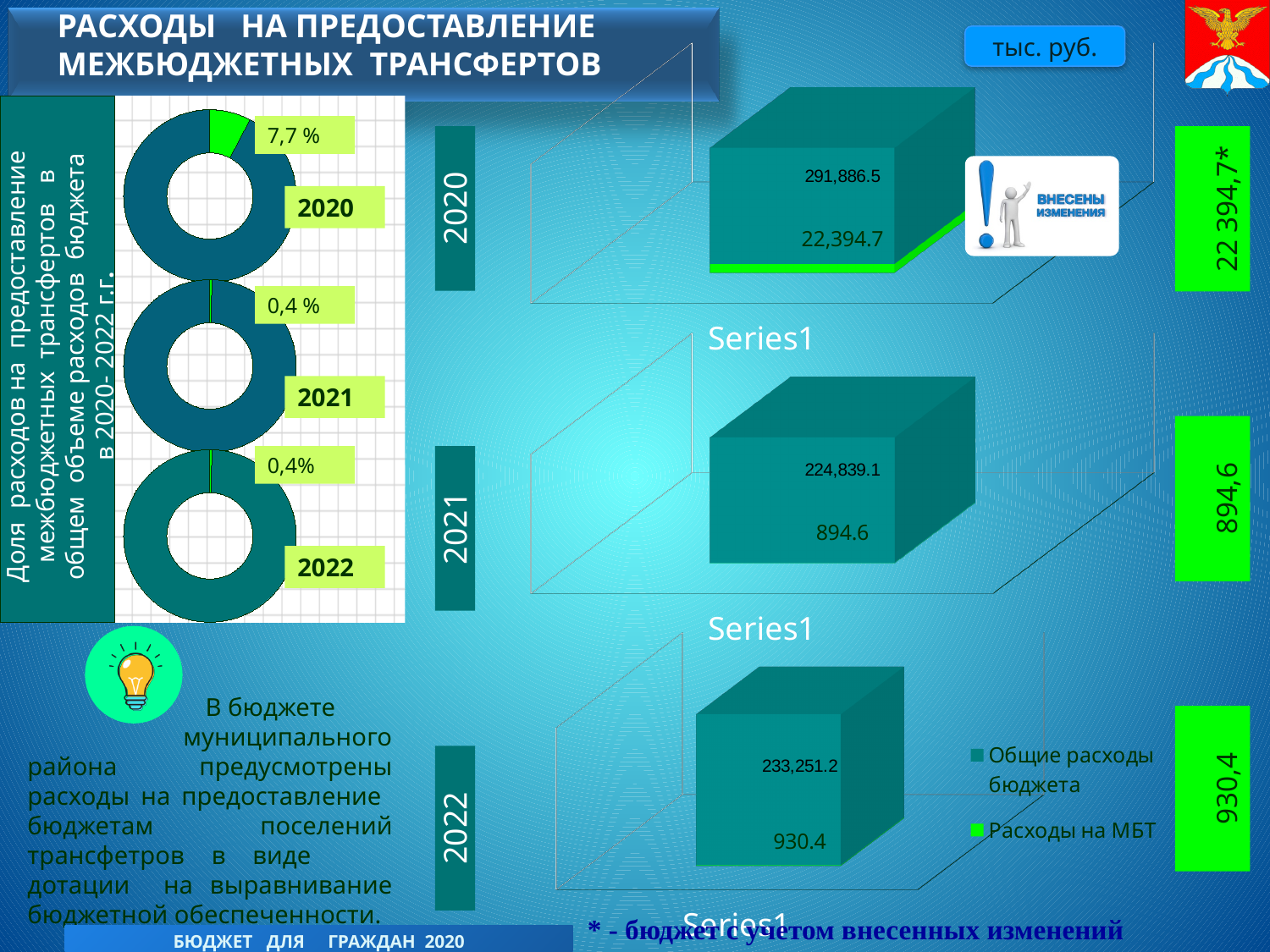
Across the three bar charts on the right, which year has the highest value for Расходы на МБТ? 2020 In the 2020 donut chart on the left, what share is shown for the highlighted slice? 7,7 % In the 2021 donut chart on the left, what share is shown for the highlighted slice? 0,4 % How many series does the legend of the bar charts on the right list? 2 In the 2021 bar chart on the right, what is the value labelled for Общие расходы бюджета? 224,839.1 In the 2020 bar chart on the right, what is the value labelled for Расходы на МБТ? 22,394.7 In the 2022 bar chart on the right, what is the value labelled for Расходы на МБТ? 930.4 What type of chart is used for the three charts on the left showing 7,7 %, 0,4 % and 0,4%? Donut (pie) chart In the 2020 bar chart on the right, what is the value labelled for Общие расходы бюджета? 291,886.5 In the 2021 bar chart on the right, what is the value labelled for Расходы на МБТ? 894.6 In the bar charts on the right, is the Расходы на МБТ value for 2022 larger or smaller than for 2021? larger In the 2022 bar chart on the right, what is the value labelled for Общие расходы бюджета? 233,251.2